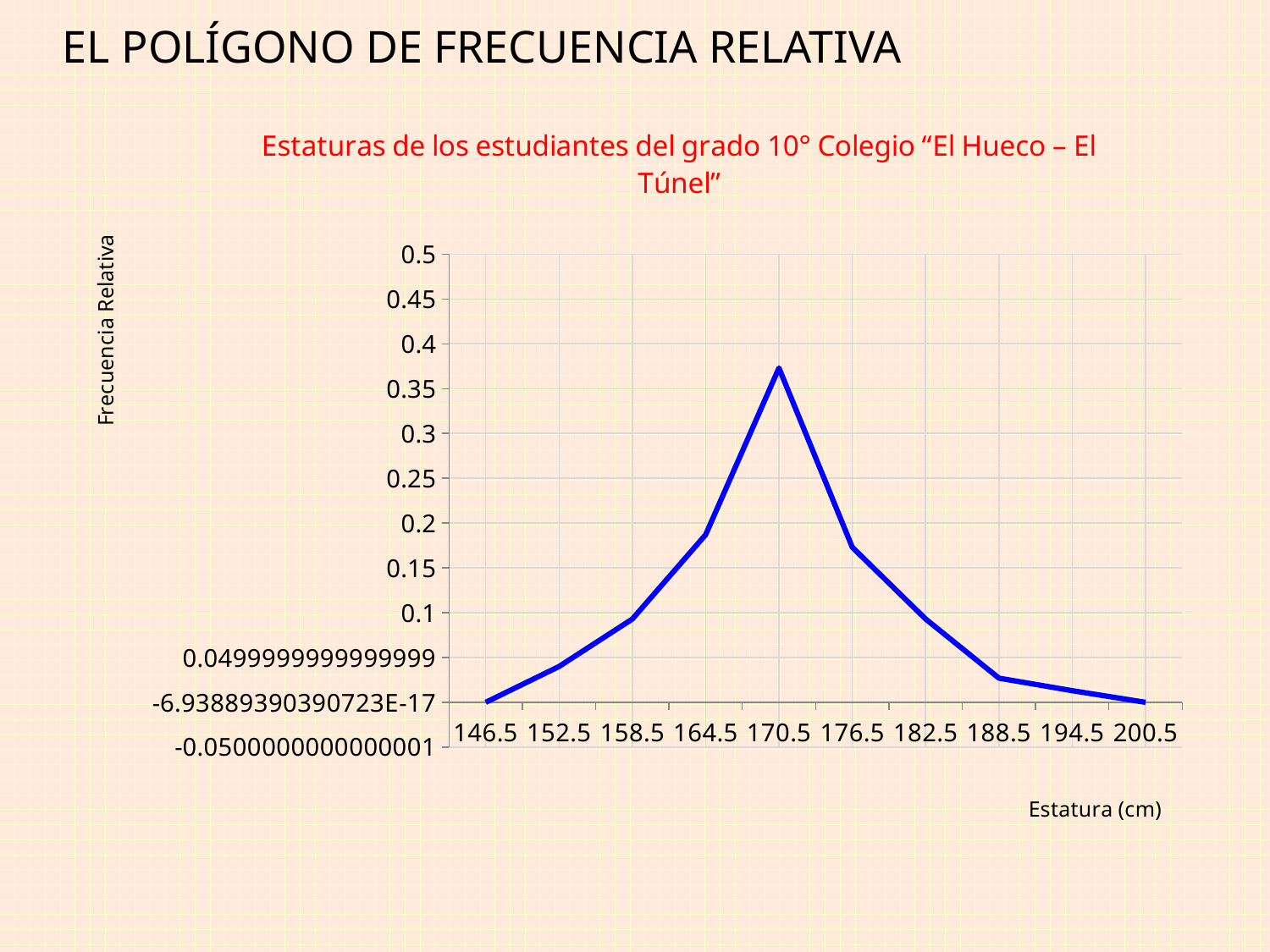
Is the relative frequency at 170.5 cm greater or less than 0.3? greater Is the relative frequency at 164.5 cm greater or less than 0.15? greater What kind of chart is shown on the slide? line chart Is the relative frequency at 188.5 cm greater or less than 0.05? less Which has the larger relative frequency, 176.5 cm or 152.5 cm? 176.5 cm Which has the larger relative frequency, 164.5 cm or 188.5 cm? 164.5 cm What is the label of the x axis? Estatura (cm) Does the relative frequency rise or fall from 170.5 cm to 200.5 cm? fall What is the title of the chart? Estaturas de los estudiantes del grado 10° Colegio "El Hueco – El Túnel" How many height categories are plotted along the x axis? 10 At which height (cm) does the relative frequency reach its highest value? 170.5